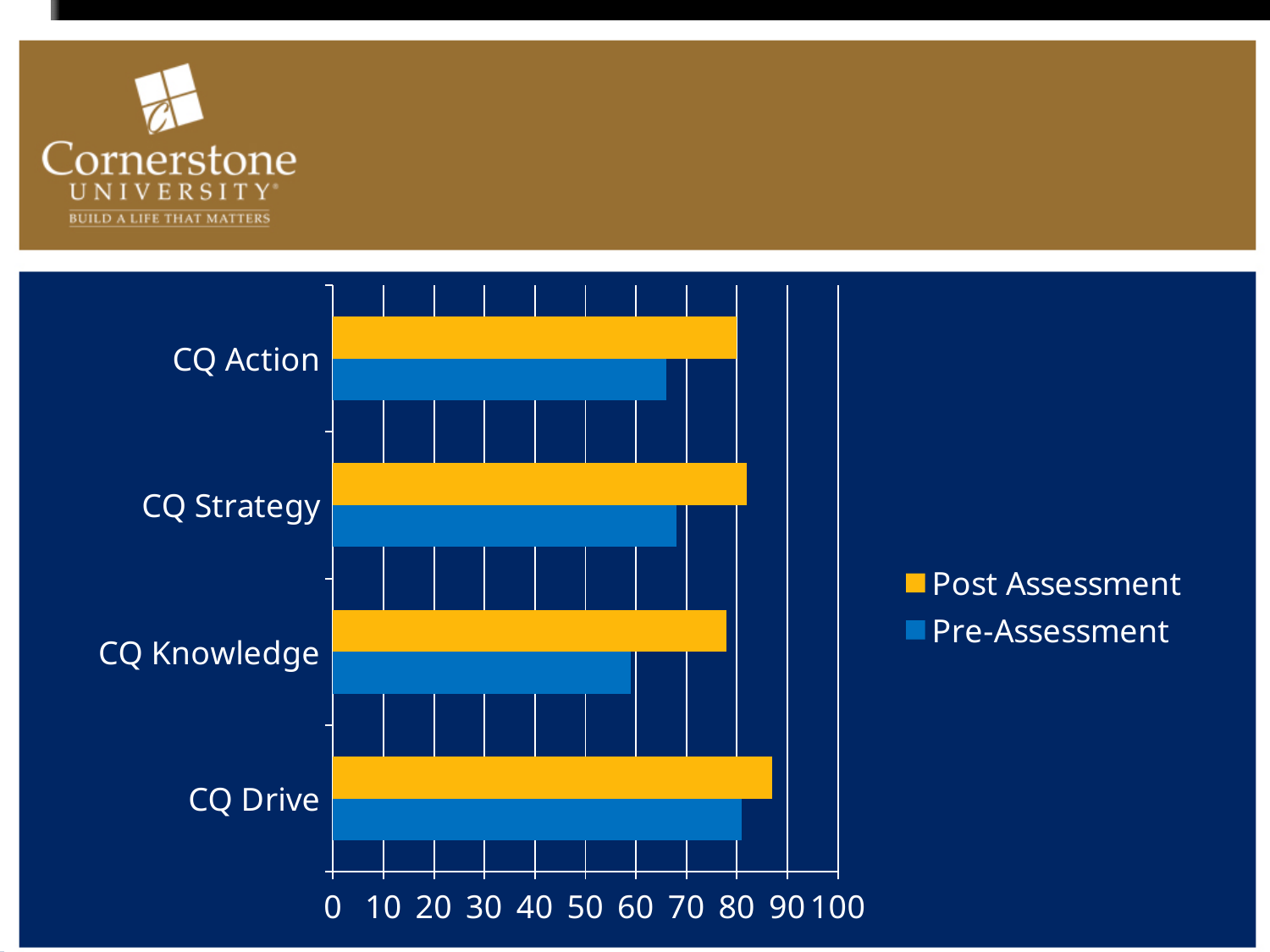
How many categories are shown on the chart? 4 Is the Pre-Assessment value for CQ Knowledge greater or less than 70? less Which category has the lowest Pre-Assessment value? CQ Knowledge Which category has the highest Post Assessment value? CQ Drive What colour represents the Post Assessment series in the legend? yellow For CQ Knowledge, which is larger: the Post Assessment value or the Pre-Assessment value? Post Assessment How many series does the legend list? 2 Is the Post Assessment value for CQ Drive greater or less than 80? greater What kind of chart is shown on the slide? bar chart Which category has the highest Pre-Assessment value? CQ Drive Is the Pre-Assessment value for CQ Drive greater or less than 70? greater